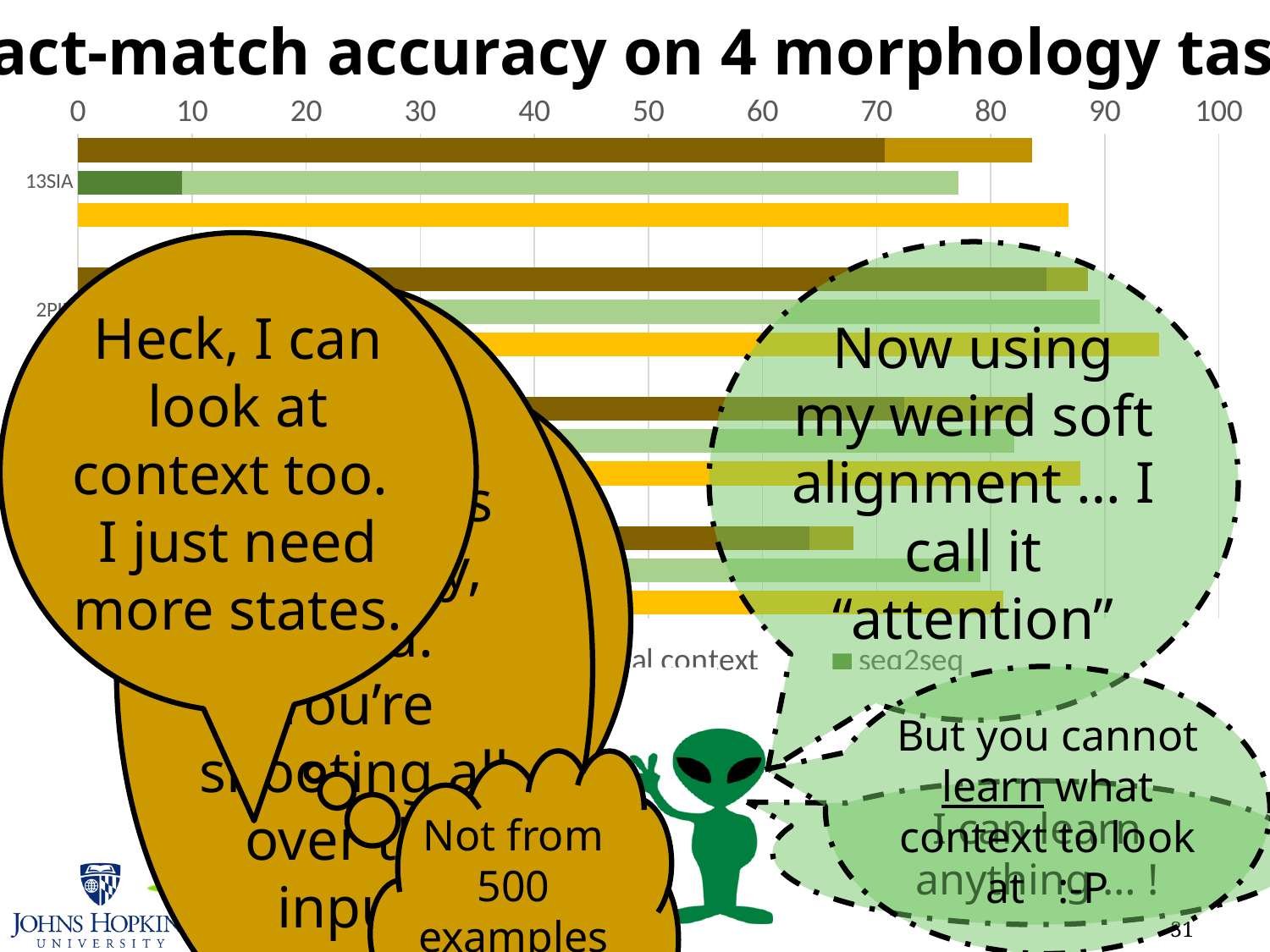
Is the value of the light green bar for 13SIA greater or less than 80? less Is the value of the light green bar for 13SIA greater or less than 50? greater Is the value of the yellow bar for 13SIA greater or less than 80? greater Which legend entry is readable at the bottom right of the chart? seq2seq For 13SIA, which bar is longer: the dark green bar or the yellow bar? the yellow bar For 13SIA, which bar is longer: the yellow bar or the light green bar? the yellow bar For 13SIA, which bar is shorter: the dark green bar or the dark brown bar? the dark green bar What kind of chart is shown on the slide? bar chart How many morphology tasks does the chart title say the accuracy is measured on? 4